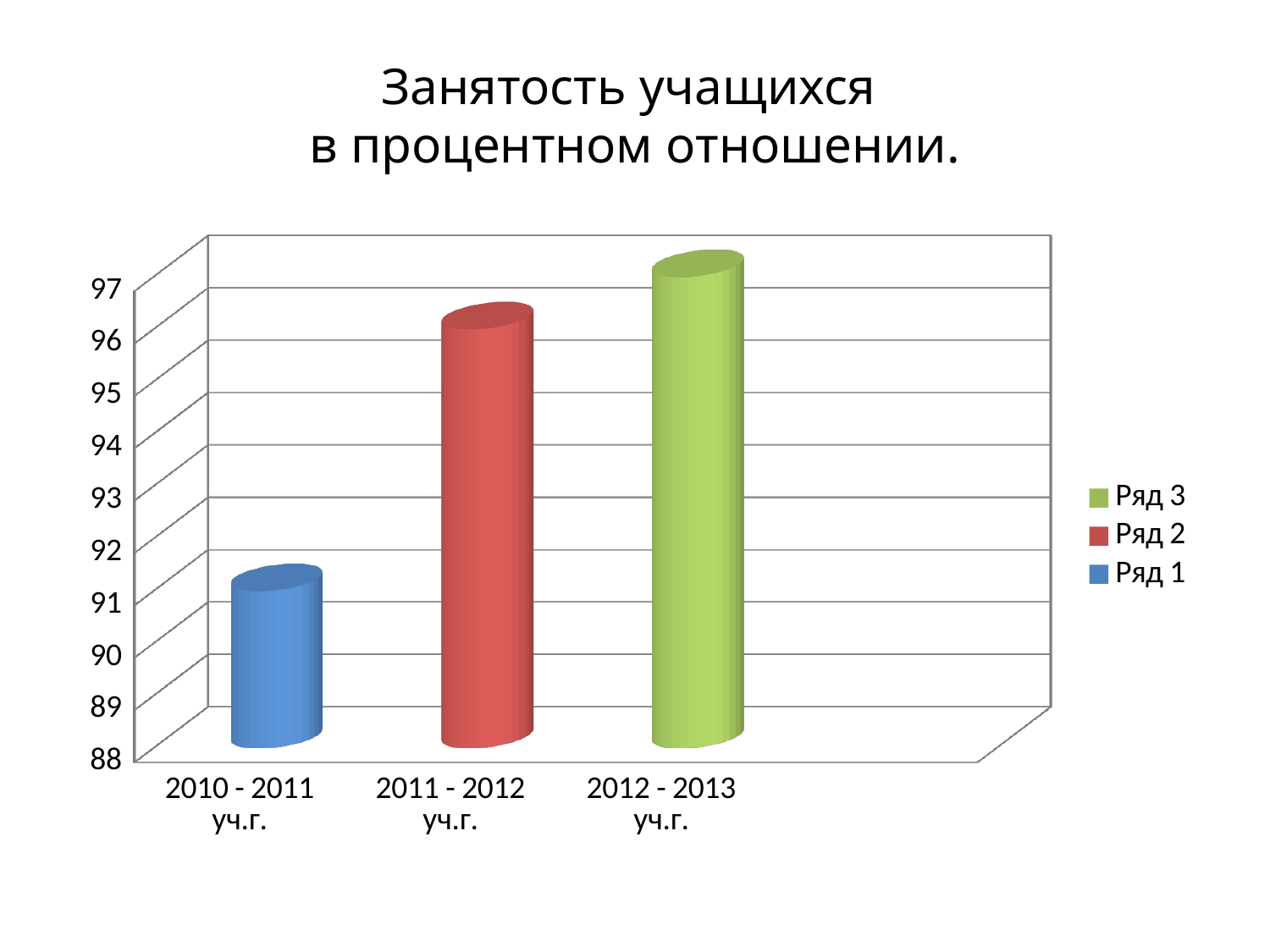
How many series does the legend list? 3 How many categories (school years) are shown on the x axis? 3 Is the value for 2012 - 2013 уч.г. greater or less than 95? greater Which school year has the lowest bar? 2010 - 2011 уч.г. Is the value for 2010 - 2011 уч.г. greater or less than 93? less Which is larger, the value for 2010 - 2011 уч.г. or the value for 2011 - 2012 уч.г.? 2011 - 2012 уч.г. Which school year has the highest bar? 2012 - 2013 уч.г. Do the values rise or fall from 2010 - 2011 уч.г. to 2012 - 2013 уч.г.? rise Is the value for 2011 - 2012 уч.г. greater or less than 94? greater What colour is the bar for 2012 - 2013 уч.г. (Ряд 3)? green What is the title of the chart? Занятость учащихся в процентном отношении. What kind of chart is shown on the slide? bar chart